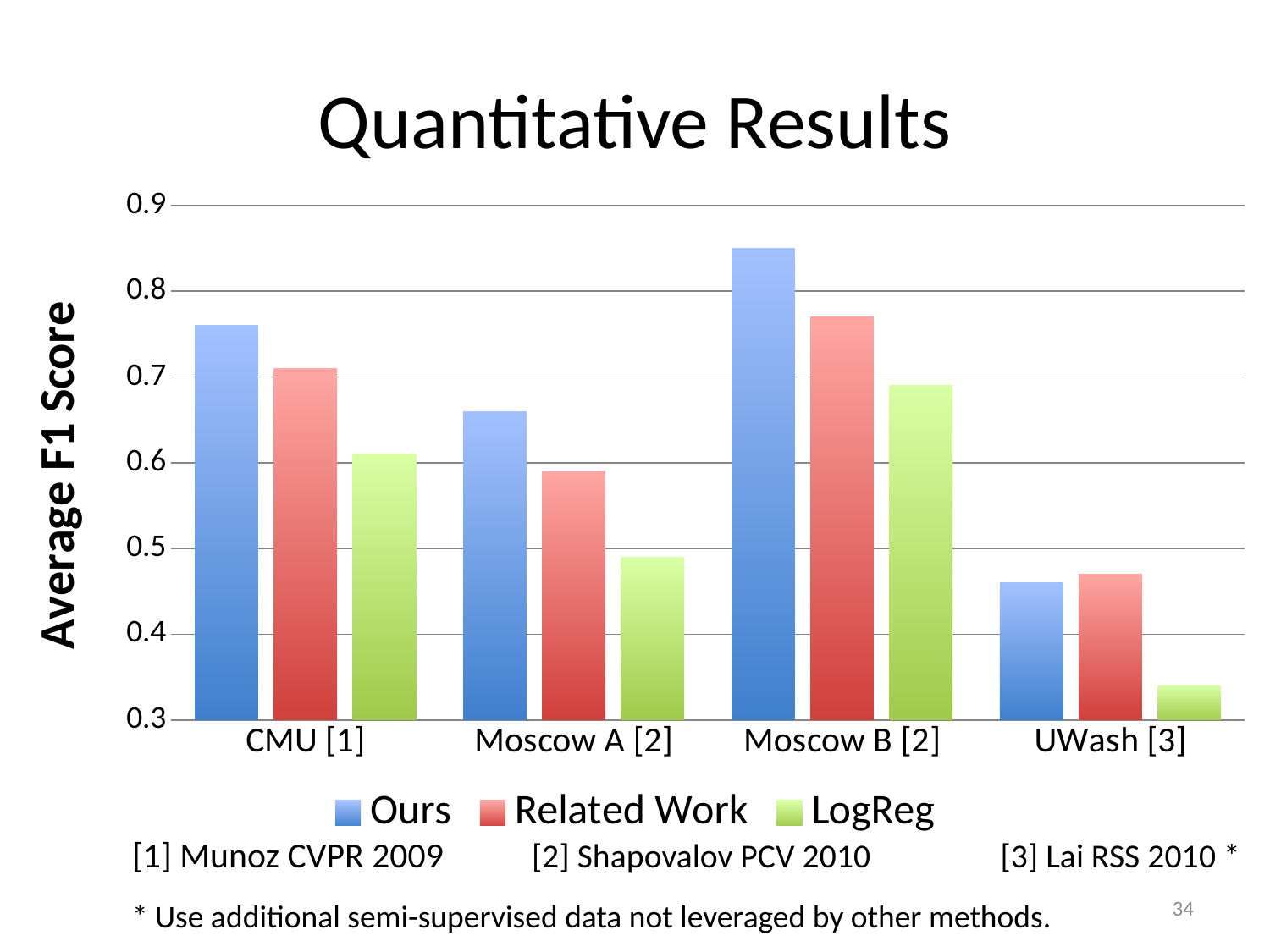
Is the Ours value for Moscow B [2] greater or less than 0.8? greater How many series does the legend list? 3 What is the label of the y axis? Average F1 Score For which dataset is the LogReg series lowest? UWash [3] For Moscow B [2], which is larger: Related Work or LogReg? Related Work For which dataset is the Ours series highest? Moscow B [2] Is the Ours value for UWash [3] greater or less than 0.5? less For CMU [1], which is larger: Ours or Related Work? Ours Is the LogReg value for UWash [3] greater or less than 0.4? less What type of chart is shown on the slide? bar chart How many dataset categories are shown on the x axis? 4